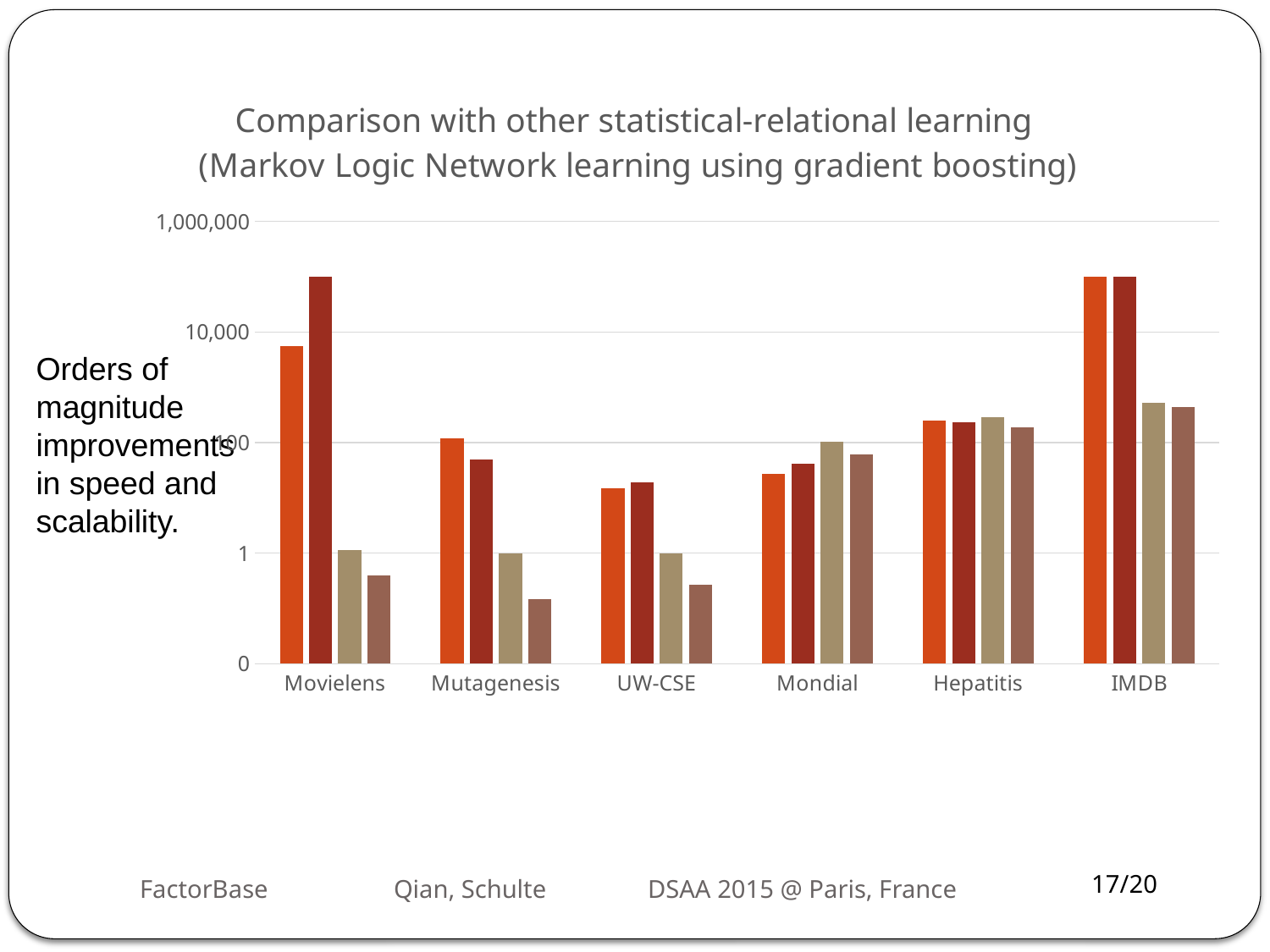
What kind of chart is shown on the slide? bar chart Is the value of the first (orange) bar for UW-CSE greater or less than 100? less What is the title of the chart? Comparison with other statistical-relational learning (Markov Logic Network learning using gradient boosting) Is the value of the second (dark red) bar for Movielens greater or less than 10,000? greater Is the value of the first (orange) bar for Movielens greater or less than 100? greater For Movielens, which is larger: the first (orange) bar or the second (dark red) bar? the second (dark red) bar What is the highest value labelled on the vertical axis of the chart? 1,000,000 How many bars are plotted for each category in the chart? 4 For Mutagenesis, which is larger: the first (orange) bar or the second (dark red) bar? the first (orange) bar How many categories are shown along the x axis of the chart? 6